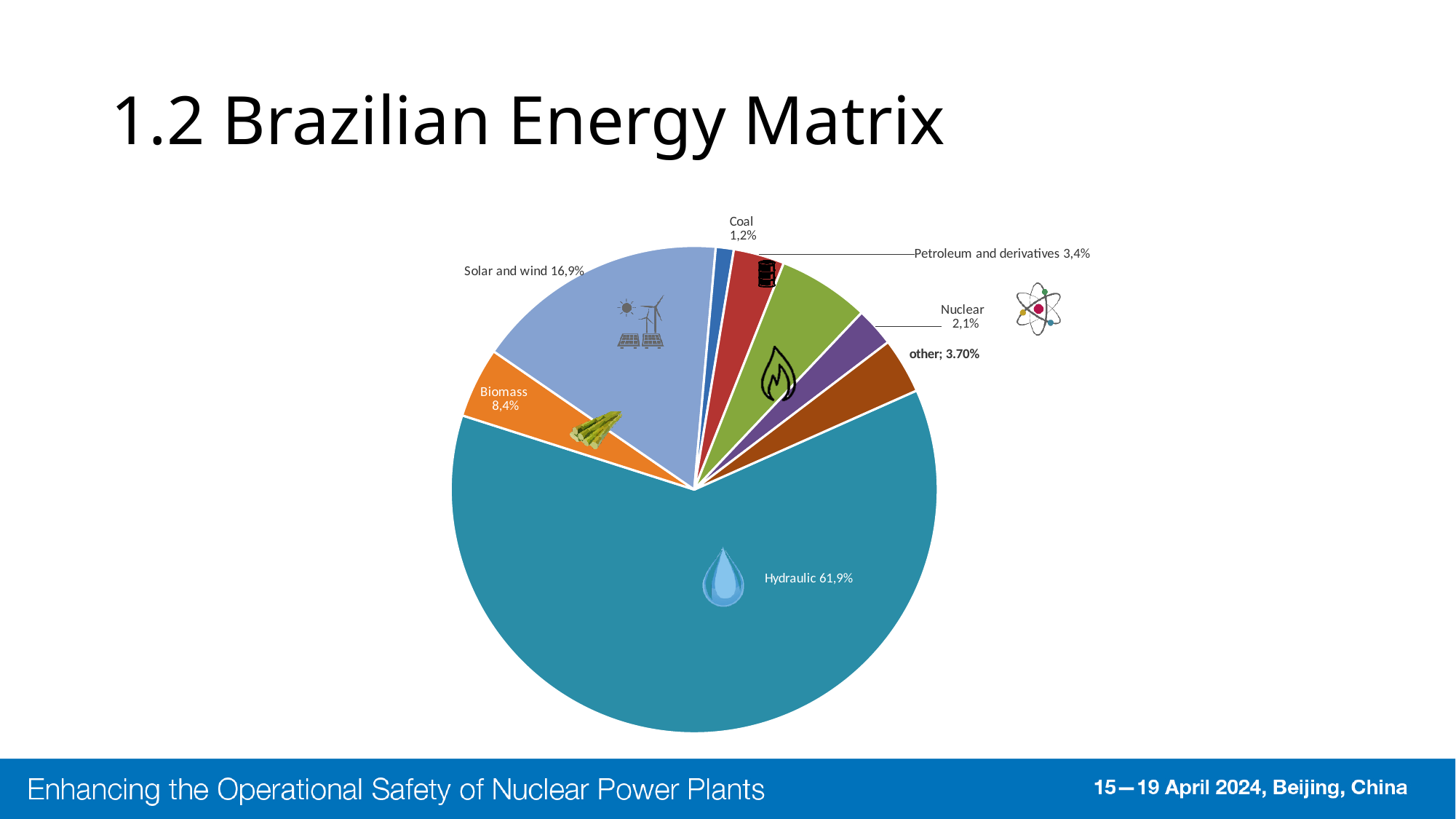
How much larger is the Solar and wind share than the Biomass share? 8,5% What share of the Brazilian energy matrix does Hydraulic account for? 61,9% Which energy source has the largest slice of the pie? Hydraulic Which labelled energy source has the smallest share? Coal What is the value labelled for Biomass? 8,4% What type of chart is shown on the slide? Pie chart What percentage is labelled for Coal? 1,2% What percentage is shown for Nuclear? 2,1% What is the value for Petroleum and derivatives? 3,4% Which is larger, the share for Petroleum and derivatives or the share for Nuclear? Petroleum and derivatives What is the title of the slide containing the chart? 1.2 Brazilian Energy Matrix What percentage is shown for Solar and wind? 16,9%